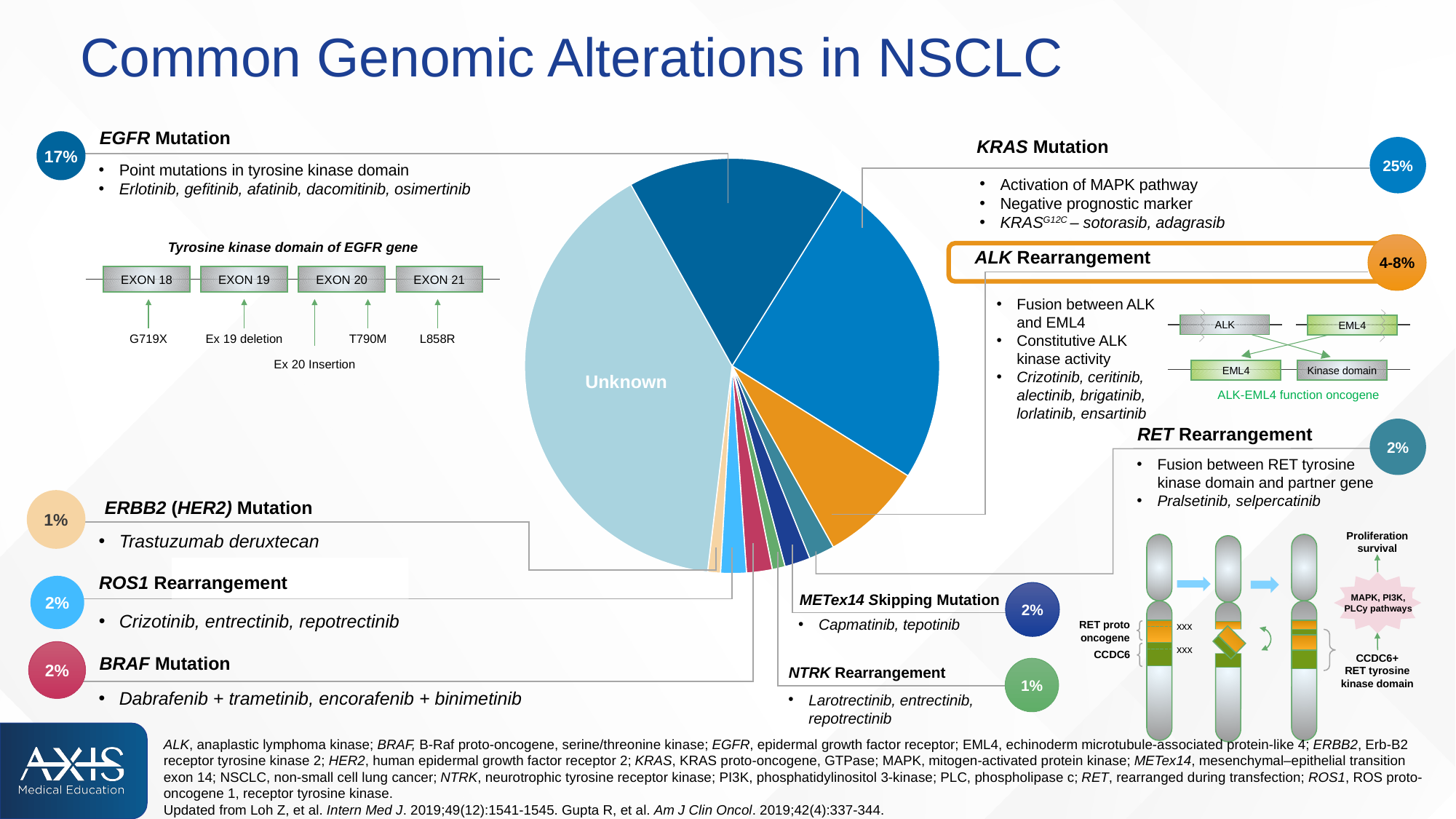
What percentage is shown for NTRK rearrangement? 1% What percentage is shown for BRAF mutation? 2% What percentage is shown for KRAS mutation? 25% What label is printed inside the largest slice of the pie chart? Unknown What percentage is shown for ERBB2 (HER2) mutation? 1% What percentage is shown for EGFR mutation? 17% Among the alterations with a percentage label, which has the highest percentage? KRAS Mutation What percentage range is shown for ALK rearrangement? 4-8% Which slice of the pie chart is the largest? Unknown Which is larger, the percentage for KRAS mutation or for EGFR mutation? KRAS mutation What is the difference between the percentages for KRAS mutation and EGFR mutation? 8% What kind of chart is shown on the slide? pie chart